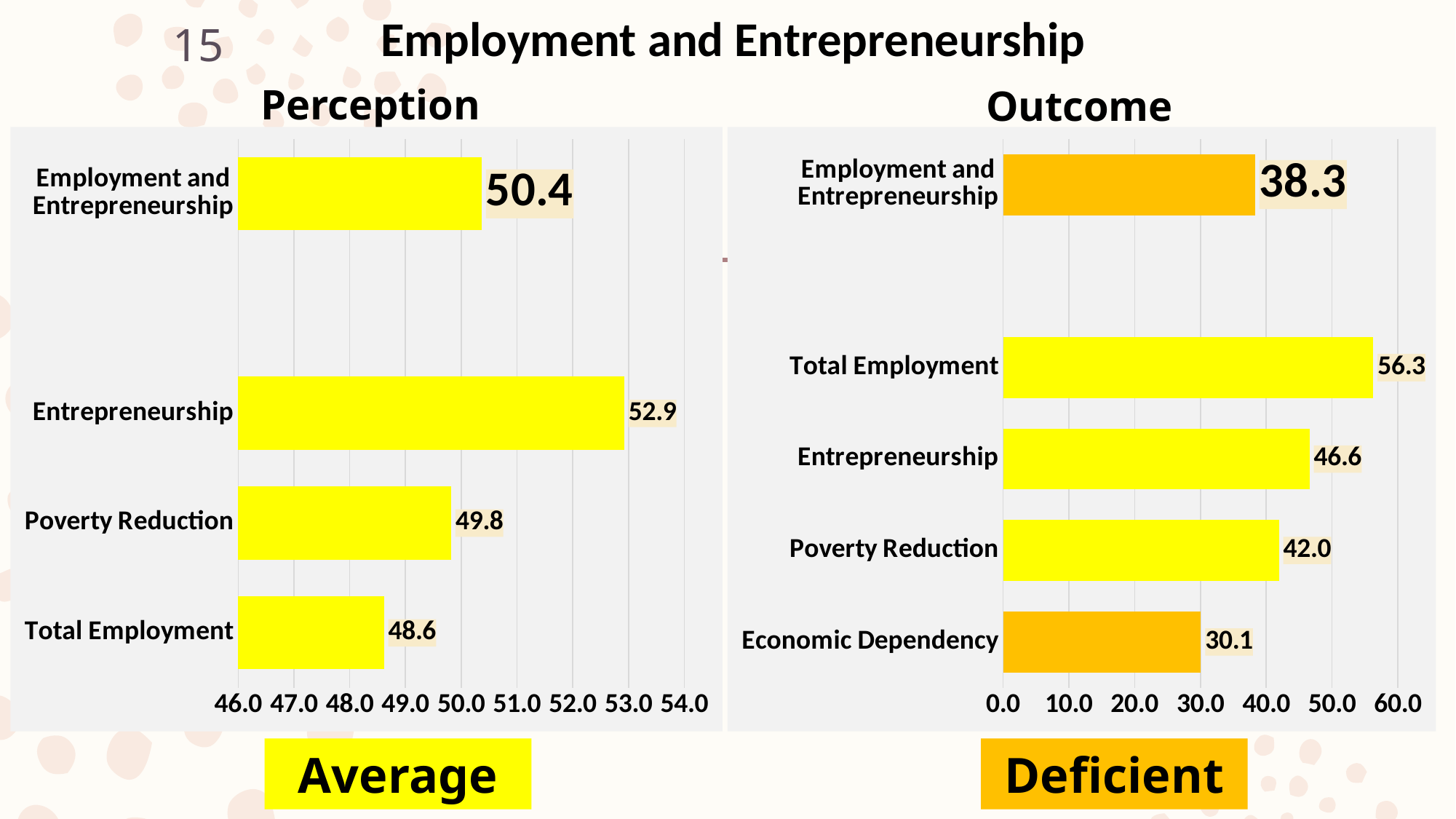
How many bars are shown in the Outcome chart? 5 In the Perception chart, which category has the lowest value? Total Employment In the Outcome chart, what is the value for Employment and Entrepreneurship? 38.3 In the Perception chart, what is the difference between Entrepreneurship and Total Employment? 4.3 In the Perception chart, is the value for Poverty Reduction greater or less than 50.0? less In the Outcome chart, what is the difference between Total Employment and Economic Dependency? 26.2 In the Outcome chart, what is the value for Economic Dependency? 30.1 In the Outcome chart, which category has the highest value? Total Employment What kind of chart is the Perception chart? bar chart In the Perception chart, what is the value for Entrepreneurship? 52.9 What rating label is shown below the Outcome chart? Deficient In the Outcome chart, which is larger, Entrepreneurship or Poverty Reduction? Entrepreneurship